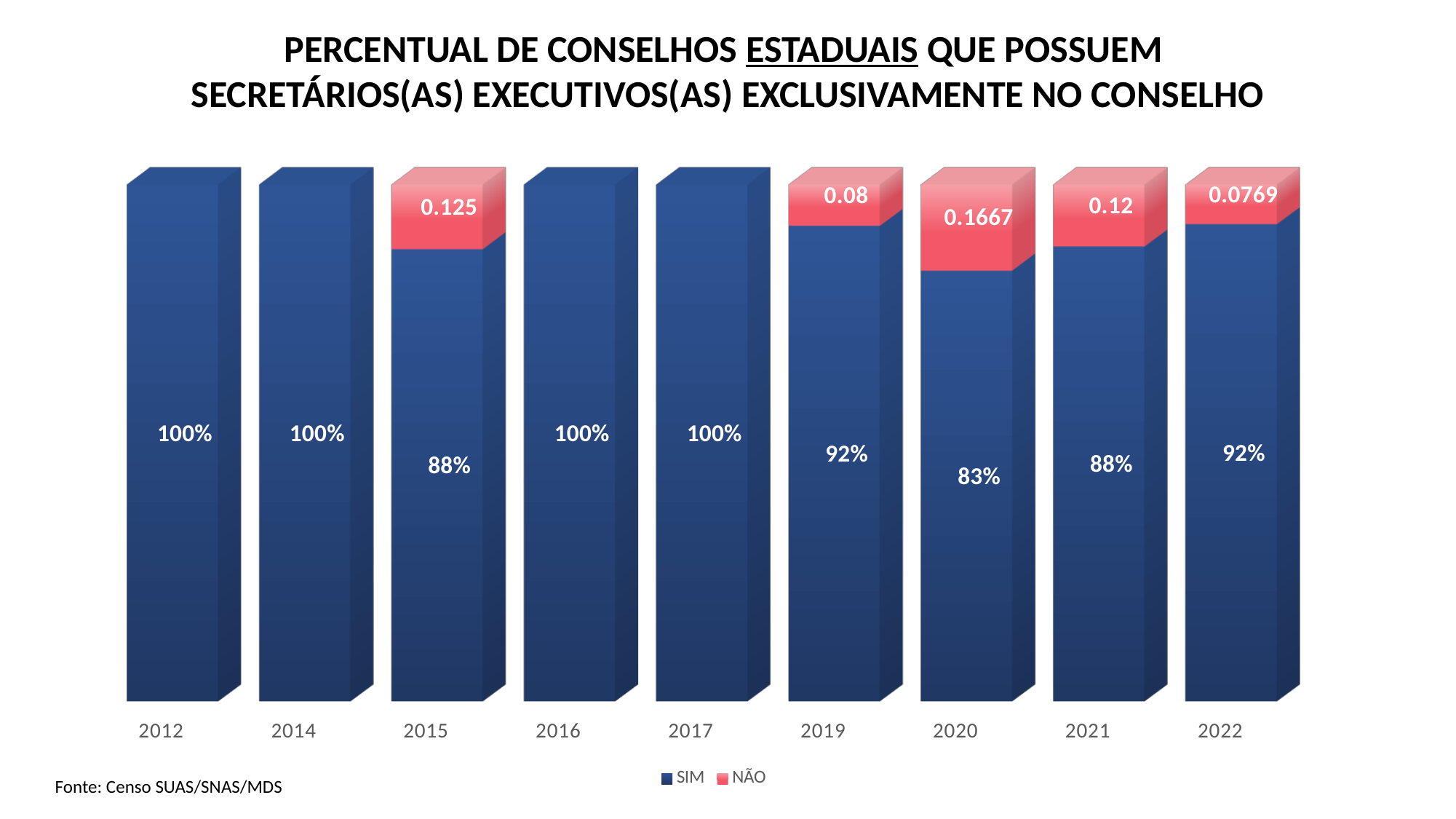
What is the NÃO value shown for 2015? 0.125 How many series does the legend list? 2 Which is larger, the SIM value for 2015 or the SIM value for 2022? 2022 Which year has the lowest SIM value? 2020 How many years are shown on the x axis? 9 What kind of chart is shown on the slide? Stacked bar chart What is the SIM value for 2019? 92% Which year has the highest NÃO value? 2020 What is the difference between the SIM values for 2017 and 2021? 12% What is the SIM value for 2020? 83% What is the NÃO value shown for 2022? 0.0769 What is the source cited for the chart? Censo SUAS/SNAS/MDS